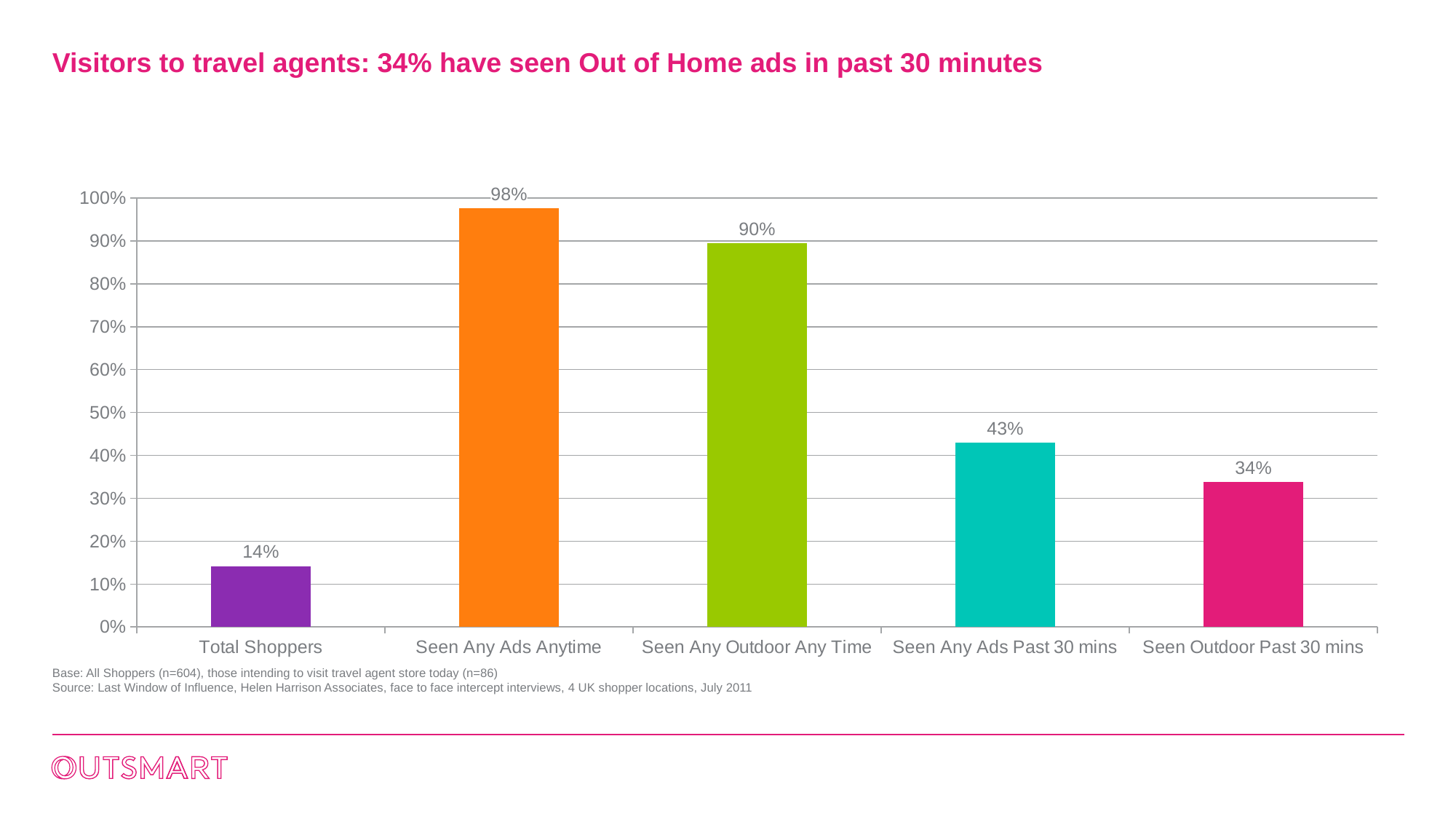
What is the value for Seen Any Ads Past 30 mins? 43% What is the value for Seen Any Ads Anytime? 98% How many categories are shown on the chart? 5 Which is larger, Seen Any Ads Anytime or Seen Any Outdoor Any Time? Seen Any Ads Anytime Which category has the lowest value? Total Shoppers What kind of chart is shown on the slide? Bar chart What is the difference between Seen Any Ads Past 30 mins and Seen Outdoor Past 30 mins? 9% What is the value for Total Shoppers? 14% What colour is the bar for Seen Outdoor Past 30 mins? Pink Which category has the highest value? Seen Any Ads Anytime What is the value for Seen Outdoor Past 30 mins? 34% What is the value for Seen Any Outdoor Any Time? 90%